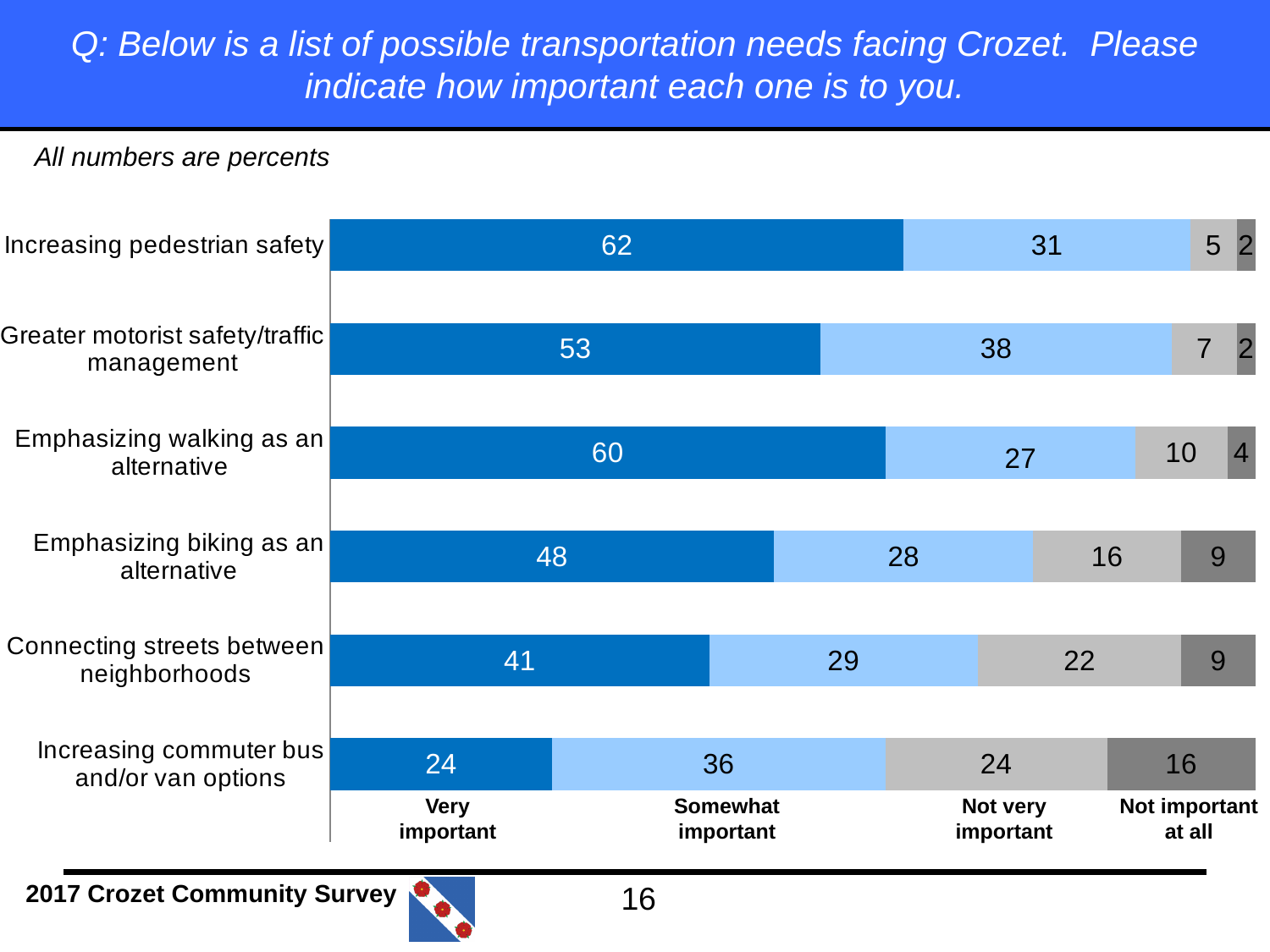
How many response categories does the legend list? 4 Which has a larger 'Not very important' value: 'Connecting streets between neighborhoods' or 'Emphasizing biking as an alternative'? Connecting streets between neighborhoods Which transportation need has the lowest 'Very important' percentage? Increasing commuter bus and/or van options What is the 'Not important at all' value for 'Increasing commuter bus and/or van options'? 16 What percentage rated 'Increasing pedestrian safety' as very important? 62 What kind of chart is shown on the slide? Stacked bar chart How many transportation needs are listed on the chart? 6 What is the difference between the 'Very important' values for 'Emphasizing walking as an alternative' and 'Emphasizing biking as an alternative'? 12 Which transportation need has the highest 'Very important' percentage? Increasing pedestrian safety What is the total of the stacked bar for 'Emphasizing biking as an alternative'? 101 What is the 'Somewhat important' value for 'Greater motorist safety/traffic management'? 38 What does the note above the chart say about the numbers? All numbers are percents